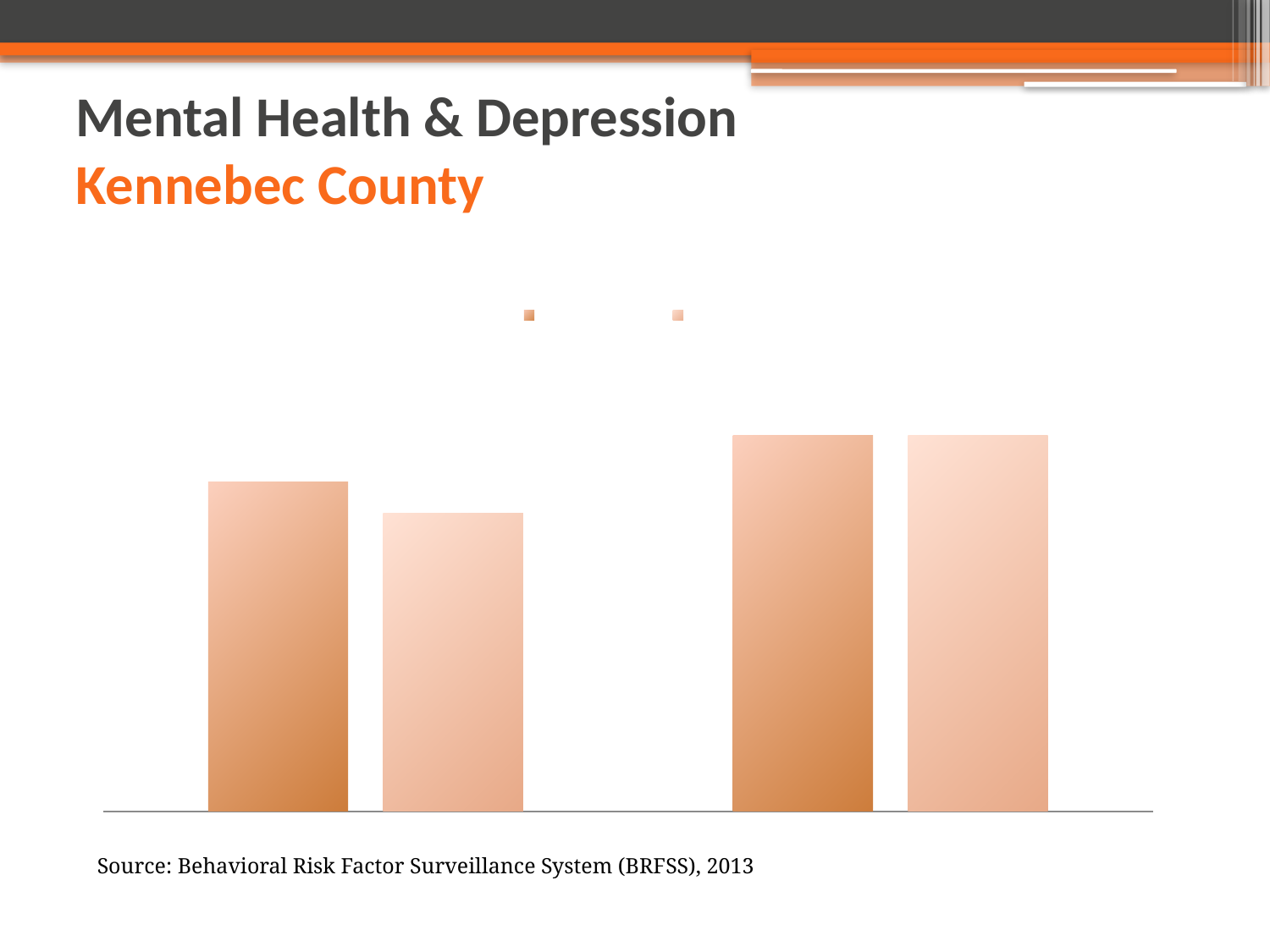
Is the leftmost bar in the chart taller or shorter than the rightmost bar? shorter Is the tallest bar in the chart in the left pair of bars or the right pair of bars? right pair How many bars are plotted in the chart? 4 What colour family are the bars in the chart? orange Is the shortest bar in the chart in the left pair of bars or the right pair of bars? left pair How many series does the chart's legend list? 2 What kind of chart is shown on the slide? bar chart Into how many groups are the bars in the chart arranged? 2